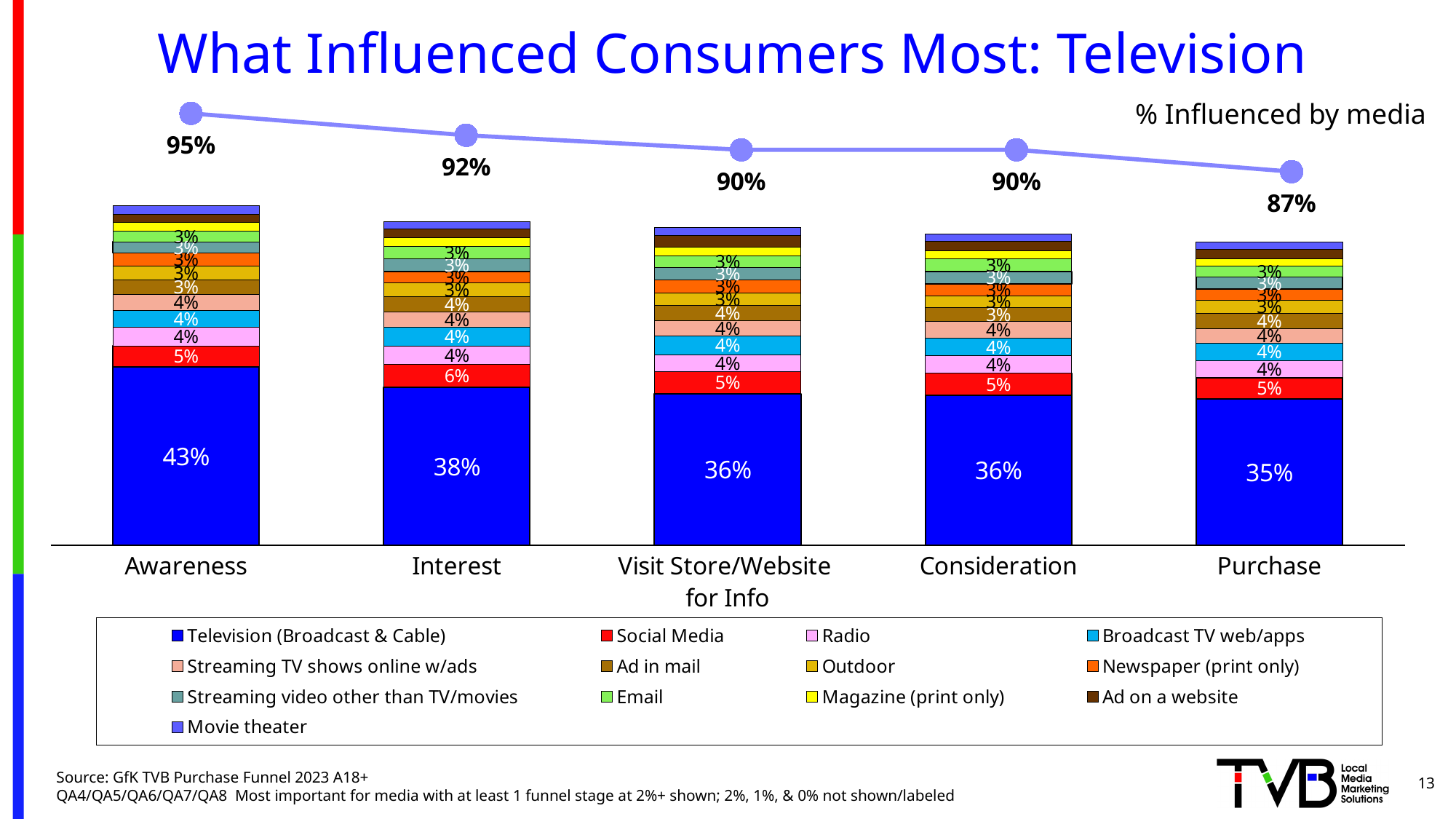
Does the % Influenced by media line rise or fall from Awareness to Purchase? fall What is the value for Television (Broadcast & Cable) at the Purchase stage? 35% How many funnel stages (categories) are shown on the x axis? 5 What is the difference between the Television (Broadcast & Cable) values at Awareness and Purchase? 8% How many series does the legend list? 13 What is the value for Television (Broadcast & Cable) at the Awareness stage? 43% Is the Social Media value larger at Interest or at Awareness? Interest At which funnel stage is the % Influenced by media value lowest? Purchase At which funnel stage is the Television (Broadcast & Cable) value highest? Awareness What is the value for Social Media at the Interest stage? 6% What is the % Influenced by media value at the Interest stage? 92% What kind of chart is shown on the slide? bar chart